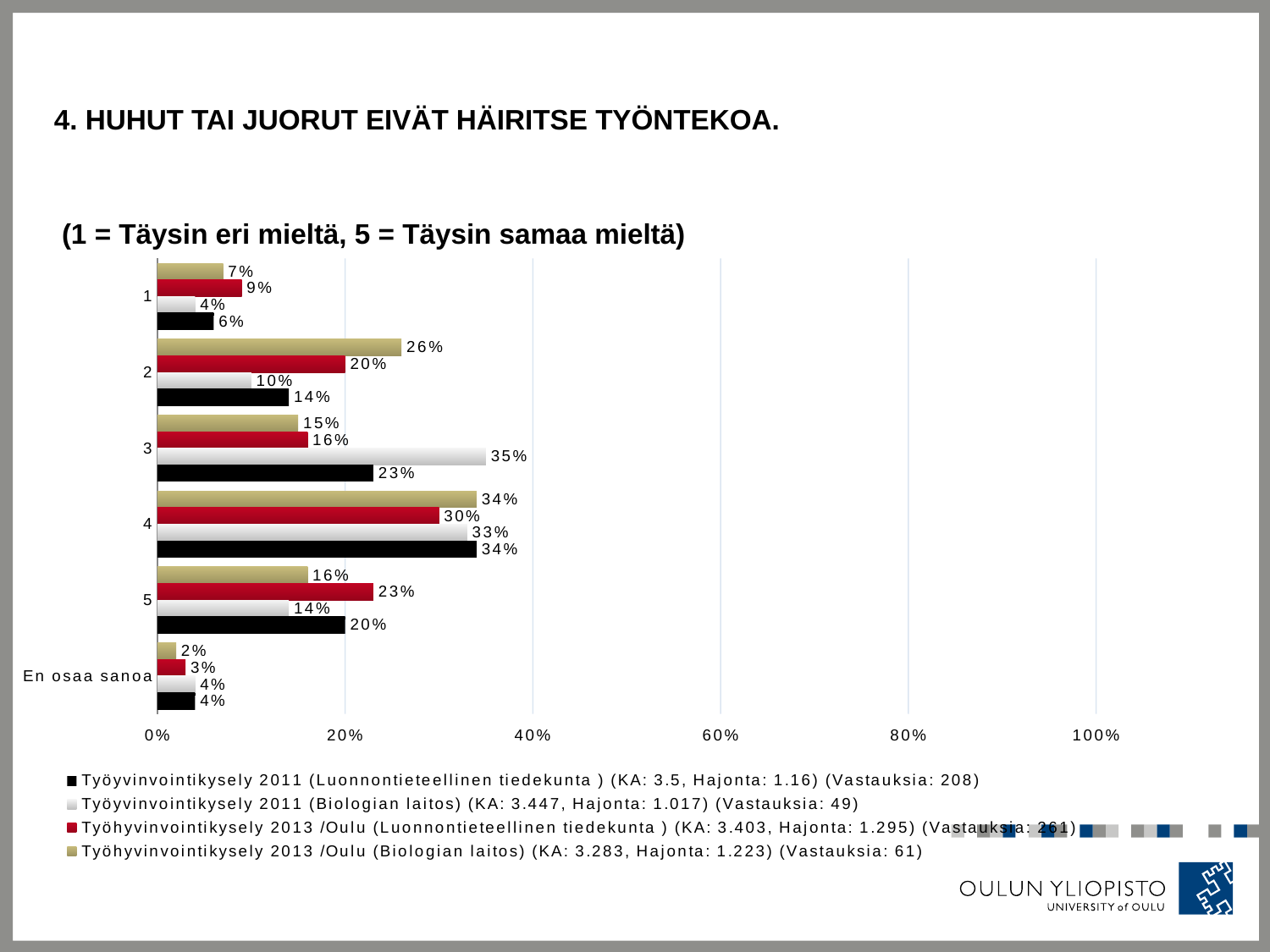
What kind of chart is shown on the slide? bar chart What is the value for category 5 in the Työhyvinvointikysely 2013 /Oulu (Luonnontieteellinen tiedekunta) series? 23% What is the value for category 2 in the Työhyvinvointikysely 2013 /Oulu (Biologian laitos) series? 26% Which category has the lowest value in the Työhyvinvointikysely 2013 /Oulu (Biologian laitos) series? En osaa sanoa How many series does the legend list? 4 Which category has the highest value in the Työyvinvointikysely 2011 (Luonnontieteellinen tiedekunta) series? 4 What is the value for 'En osaa sanoa' in the Työhyvinvointikysely 2013 /Oulu (Biologian laitos) series? 2% Is the value for category 4 in the Työyvinvointikysely 2011 (Luonnontieteellinen tiedekunta) series greater or less than 20%? greater For category 3, what is the difference between the Työyvinvointikysely 2011 (Biologian laitos) value and the Työyvinvointikysely 2011 (Luonnontieteellinen tiedekunta) value? 12 percentage points What is the value for category 3 in the Työyvinvointikysely 2011 (Biologian laitos) series? 35% How many categories are shown on the vertical axis of the chart? 6 For category 2, which series has the larger value: Työhyvinvointikysely 2013 /Oulu (Biologian laitos) or Työhyvinvointikysely 2013 /Oulu (Luonnontieteellinen tiedekunta)? Työhyvinvointikysely 2013 /Oulu (Biologian laitos)